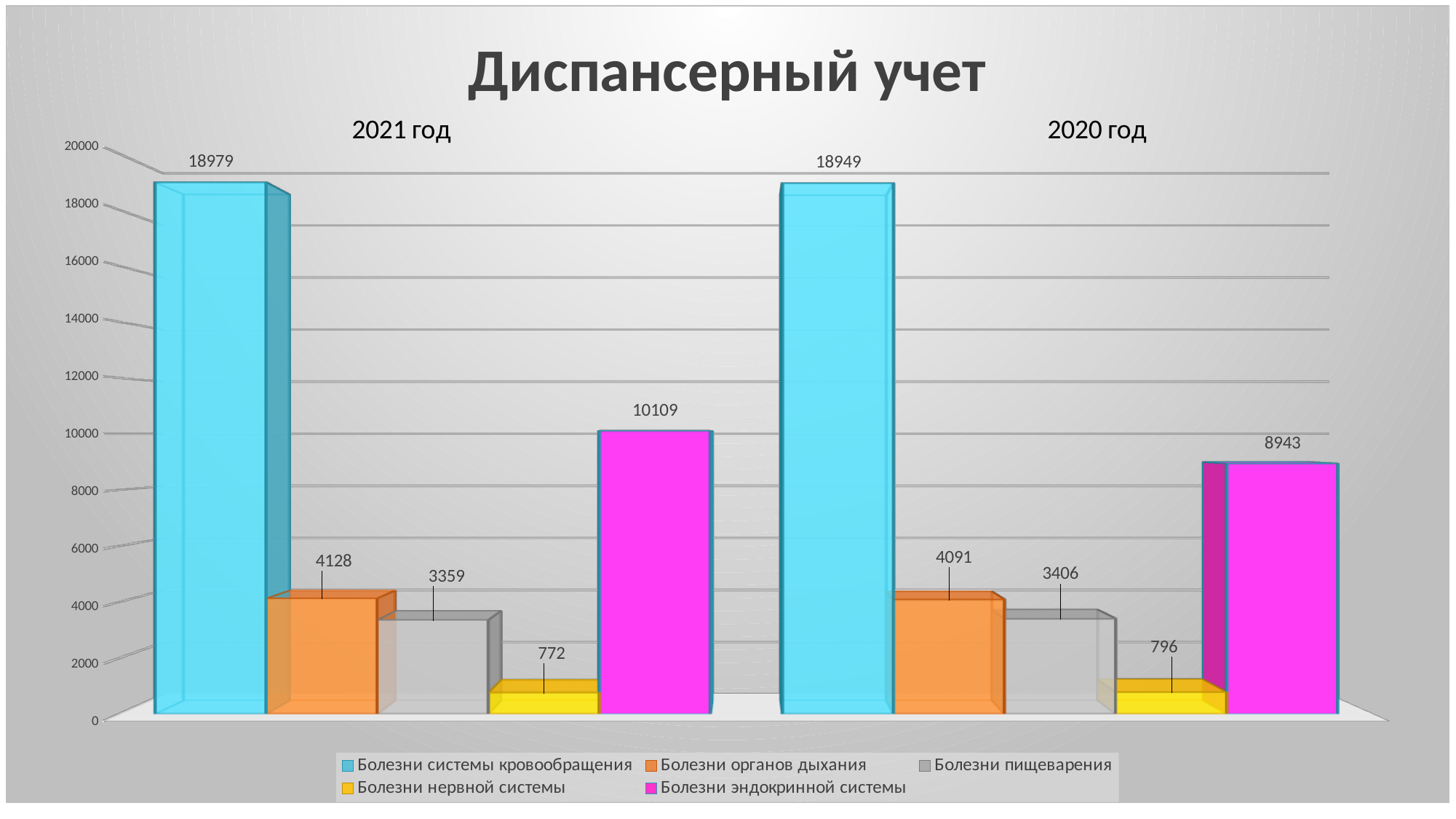
What is the value for Болезни системы кровообращения in 2021 год? 18979 What is the value for Болезни эндокринной системы in 2020 год? 8943 What kind of chart is shown on the slide? bar chart How many series does the legend list? 5 Which series has the highest value in 2020 год? Болезни системы кровообращения Which is larger: Болезни органов дыхания in 2021 год or in 2020 год? 2021 год Which series has the lowest value in 2021 год? Болезни нервной системы What is the title of the chart? Диспансерный учет Is the value for Болезни эндокринной системы in 2021 год greater or less than 10000? greater What is the value for Болезни пищеварения in 2020 год? 3406 What is the value for Болезни нервной системы in 2021 год? 772 What is the difference between the Болезни эндокринной системы values for 2021 год and 2020 год? 1166